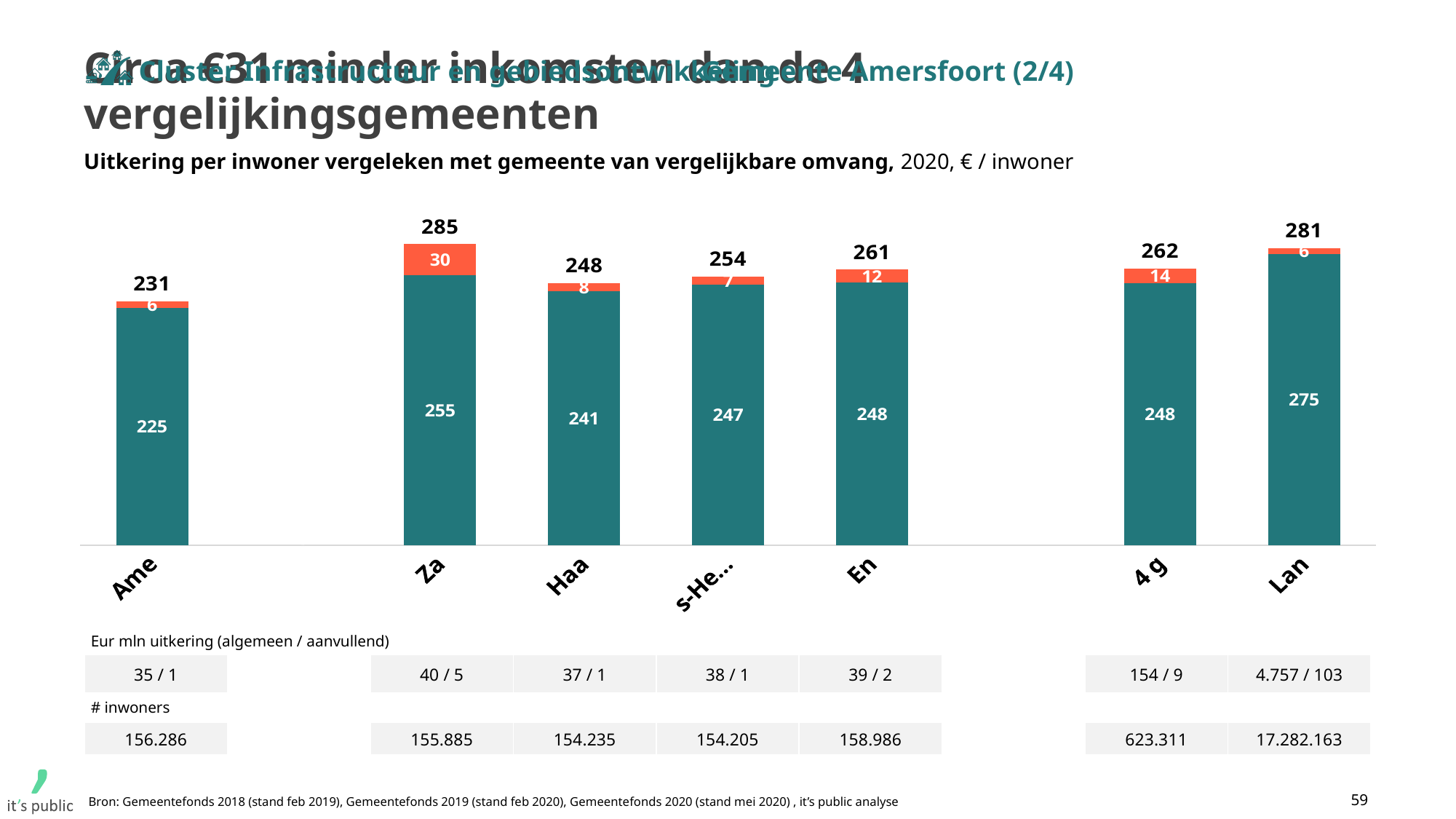
What kind of chart is shown on the slide? Stacked bar chart What is the value of the teal (lower) segment for Lan? 275 What is the total value shown above the bar for Lan? 281 What is the difference between the total for Za and the total for Ame? 54 Which has a larger orange (upper) segment, Za or En? Za What unit is stated in the chart subtitle for the values? € / inwoner How many bars are shown in the chart? 7 What is the value of the orange (upper) segment for 4 g? 14 Which category has the lowest total value? Ame Which category has the highest total value? Za What is the total value shown above the bar for Za? 285 What is the value of the teal (lower) segment for Ame? 225